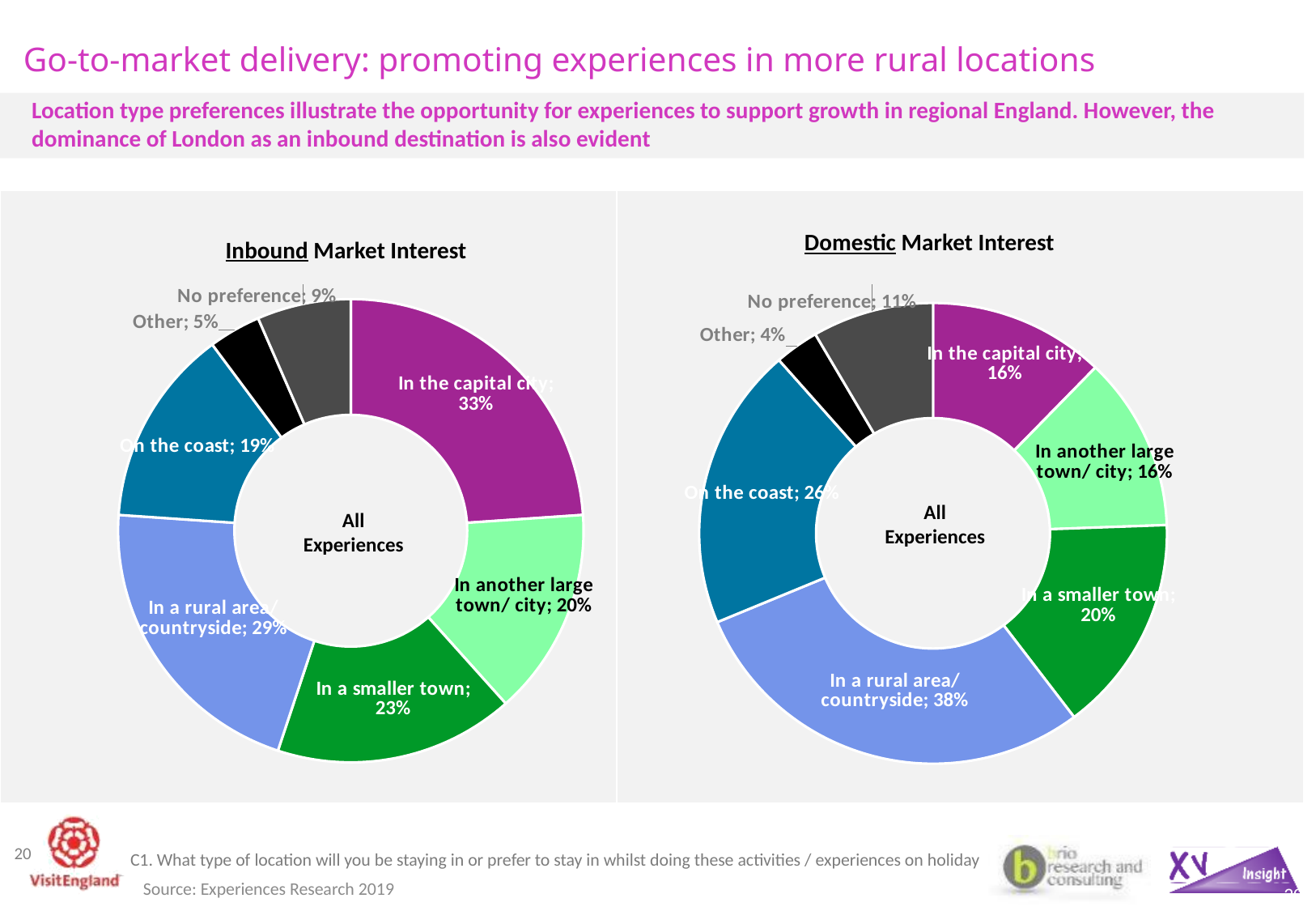
Which chart shows a higher value for 'No preference', Inbound or Domestic? Domestic What text appears in the centre of both charts? All Experiences In the Domestic Market Interest chart, which location type has the smallest share? Other How many categories are shown in the Domestic Market Interest chart? 7 In the Inbound Market Interest chart, what percentage is shown for 'In the capital city'? 33% In the Domestic Market Interest chart, what percentage is shown for 'In a rural area/ countryside'? 38% In the Domestic Market Interest chart, what is the difference between 'In a rural area/ countryside' and 'In the capital city'? 22 percentage points In the Domestic Market Interest chart, what percentage is shown for 'On the coast'? 26% What type of chart is the Inbound Market Interest chart? Doughnut (pie) chart In the Inbound Market Interest chart, which location type has the largest share? In the capital city Which is larger in the Inbound Market Interest chart: 'In a smaller town' or 'In another large town/ city'? In a smaller town In the Inbound Market Interest chart, what is the difference between 'In the capital city' and 'In a rural area/ countryside'? 4 percentage points